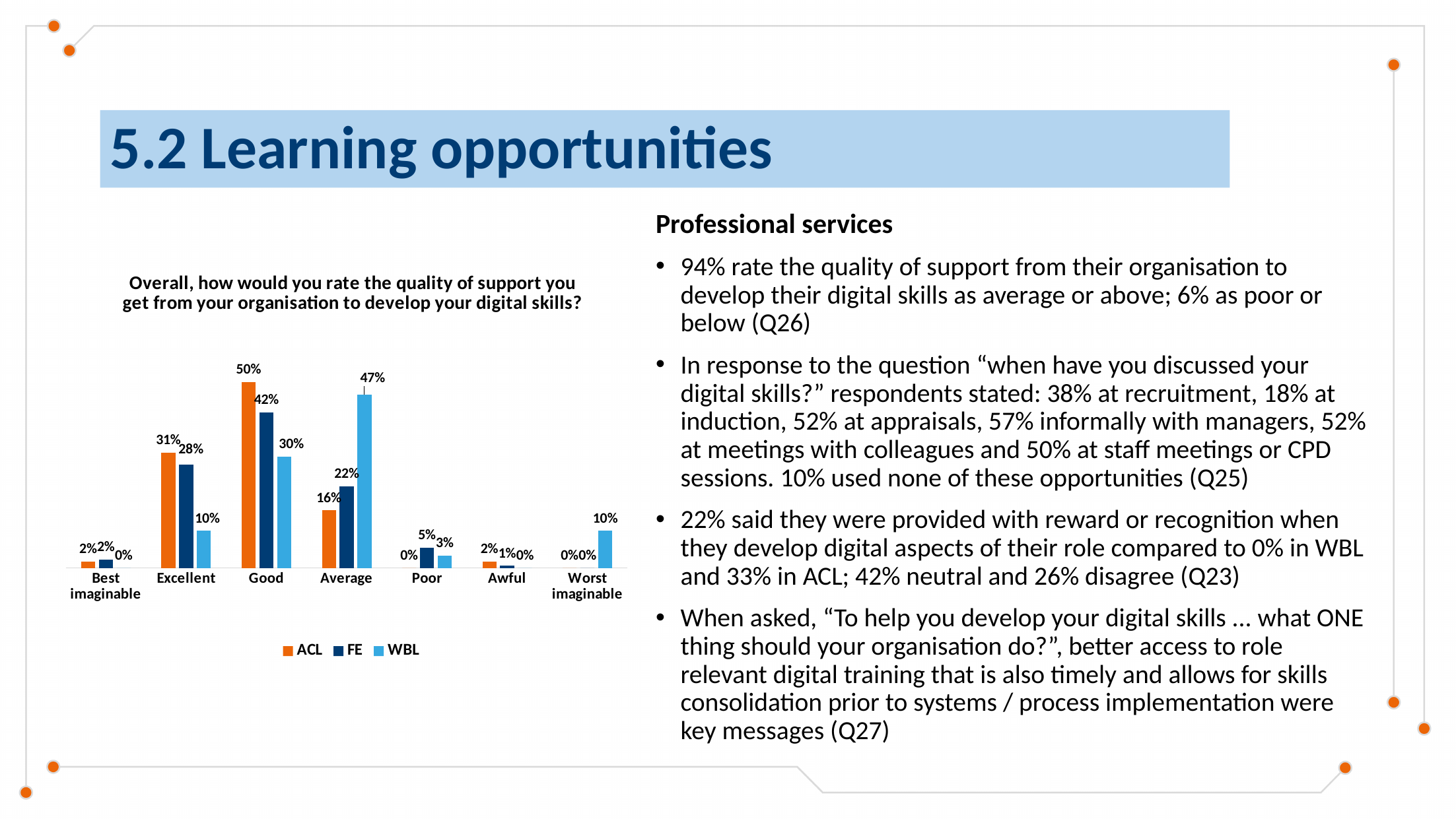
What is the difference between the WBL and ACL values for Average? 31% Which category has the highest WBL value? Average How many series does the legend list? 3 What is the WBL value for Worst imaginable? 10% How many rating categories are shown on the x axis? 7 What is the FE value for the Excellent category? 28% Which category has the highest ACL value? Good What percentage of ACL respondents rated the quality of support as Good? 50% Which is larger for the Excellent category, the ACL value or the WBL value? ACL What is the difference between the ACL and FE values for Good? 8% What type of chart is shown on the slide? Bar chart What is the WBL value for the Average category? 47%